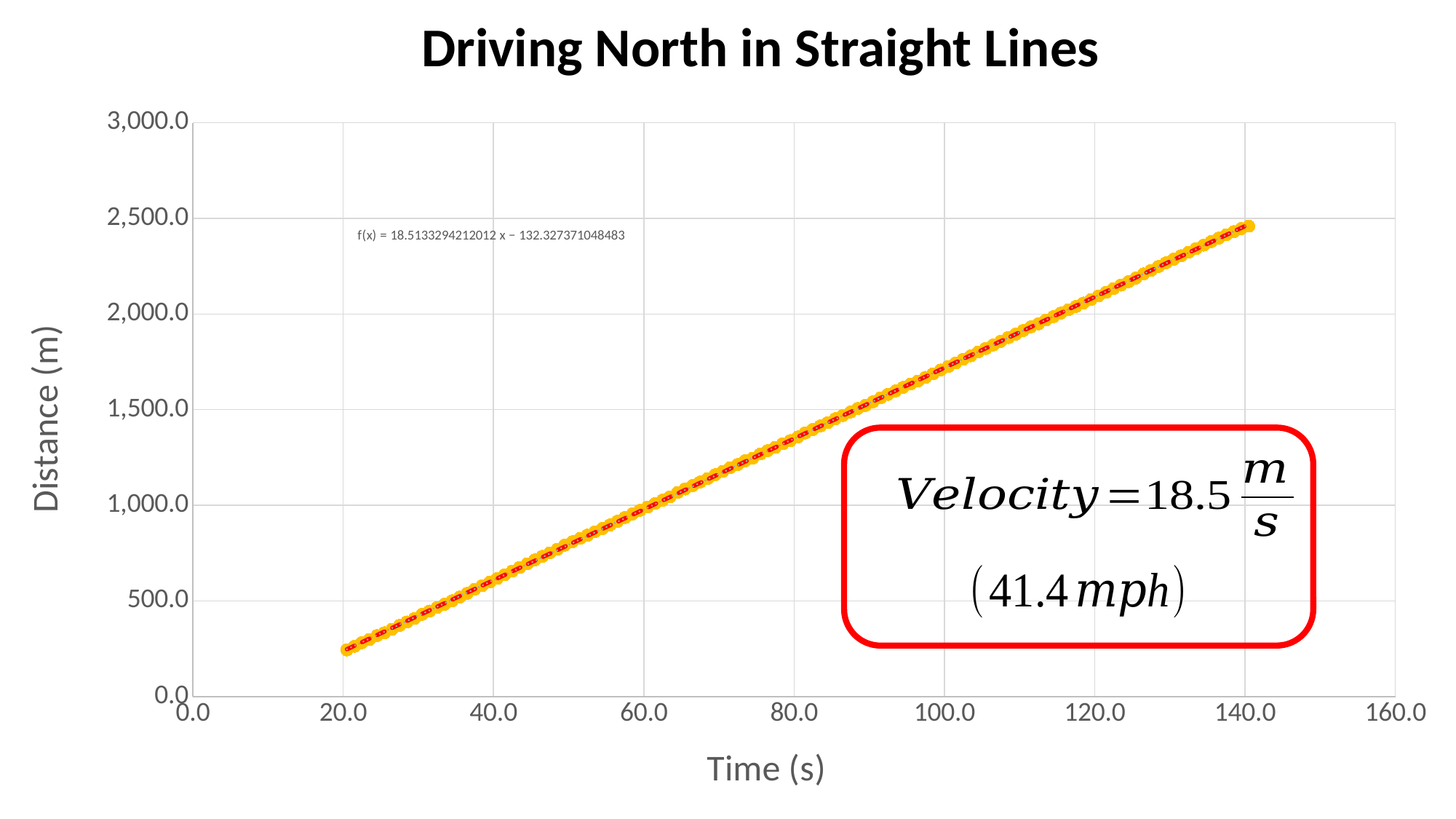
Does the distance rise or fall as time increases along the x axis? rise Is the distance at a time of 100.0 s greater or less than 1,500.0 m? greater Is the distance at a time of 80.0 s greater or less than 1,500.0 m? less What kind of chart is shown on the slide? scatter chart What is the label of the x axis? Time (s) Is the distance at a time of 20.0 s greater or less than 500.0 m? less What is the title of the chart? Driving North in Straight Lines What is the slope of the trendline equation f(x) shown on the chart? 18.5133294212012 What is the highest value shown on the y axis? 3,000.0 What velocity in m/s is stated in the red box on the chart? 18.5 m/s What velocity in mph is stated in the red box on the chart? 41.4 mph